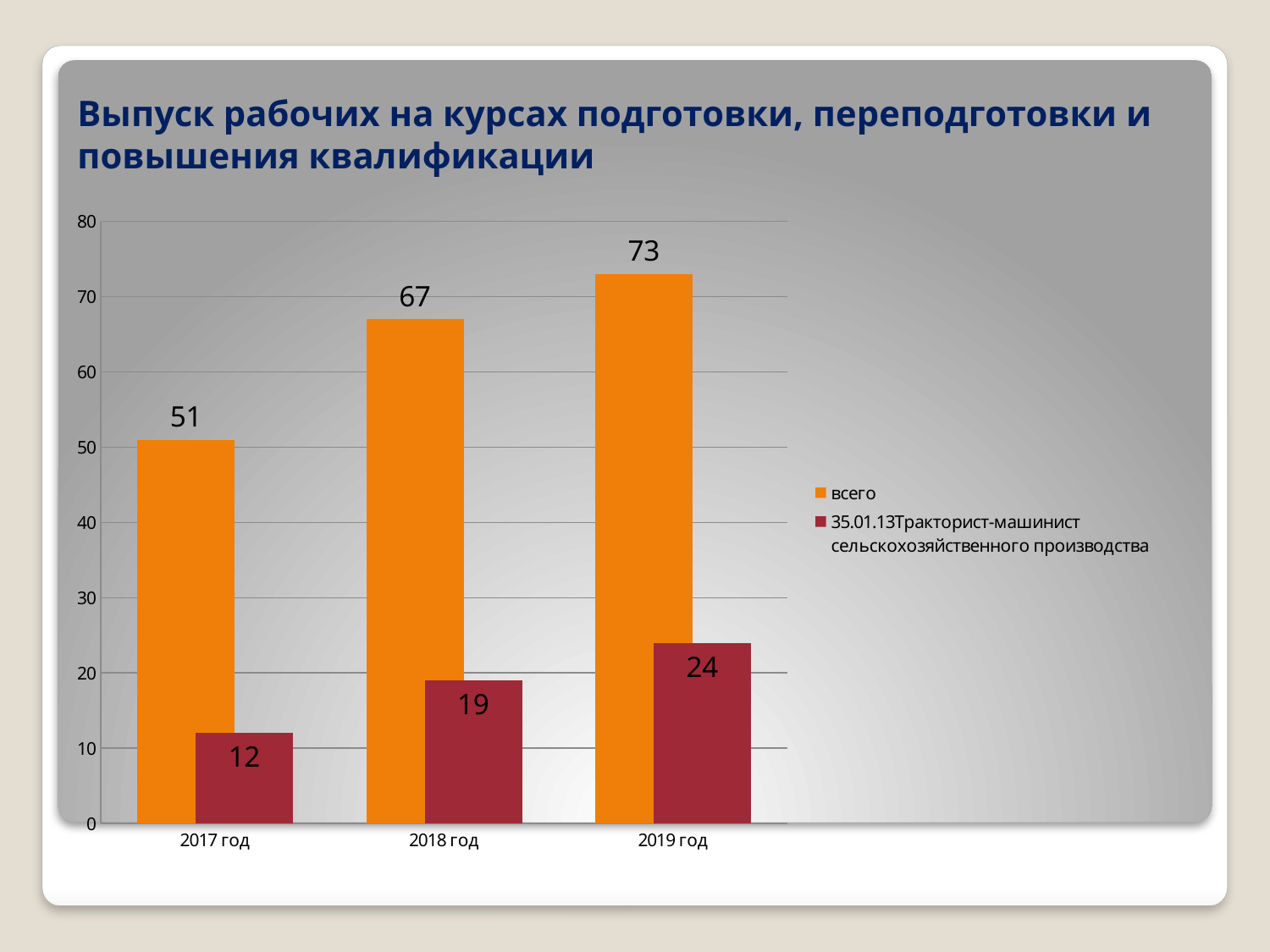
What is the difference between the 'всего' value and the '35.01.13Тракторист-машинист сельскохозяйственного производства' value for 2018 год? 48 How many years are shown on the x axis? 3 What is the value of the 'всего' series for 2018 год? 67 What kind of chart is shown on the slide? Bar chart Which year has the highest value for the 'всего' series? 2019 год Which is larger: the '35.01.13Тракторист-машинист сельскохозяйственного производства' value for 2018 год or for 2019 год? 2019 год What is the difference between the 'всего' values for 2019 год and 2017 год? 22 What is the value of the '35.01.13Тракторист-машинист сельскохозяйственного производства' series for 2017 год? 12 Which year has the lowest value for the '35.01.13Тракторист-машинист сельскохозяйственного производства' series? 2017 год What is the value of the 'всего' series for 2019 год? 73 Do the 'всего' values rise or fall from 2017 год to 2019 год? Rise How many series does the legend list? 2